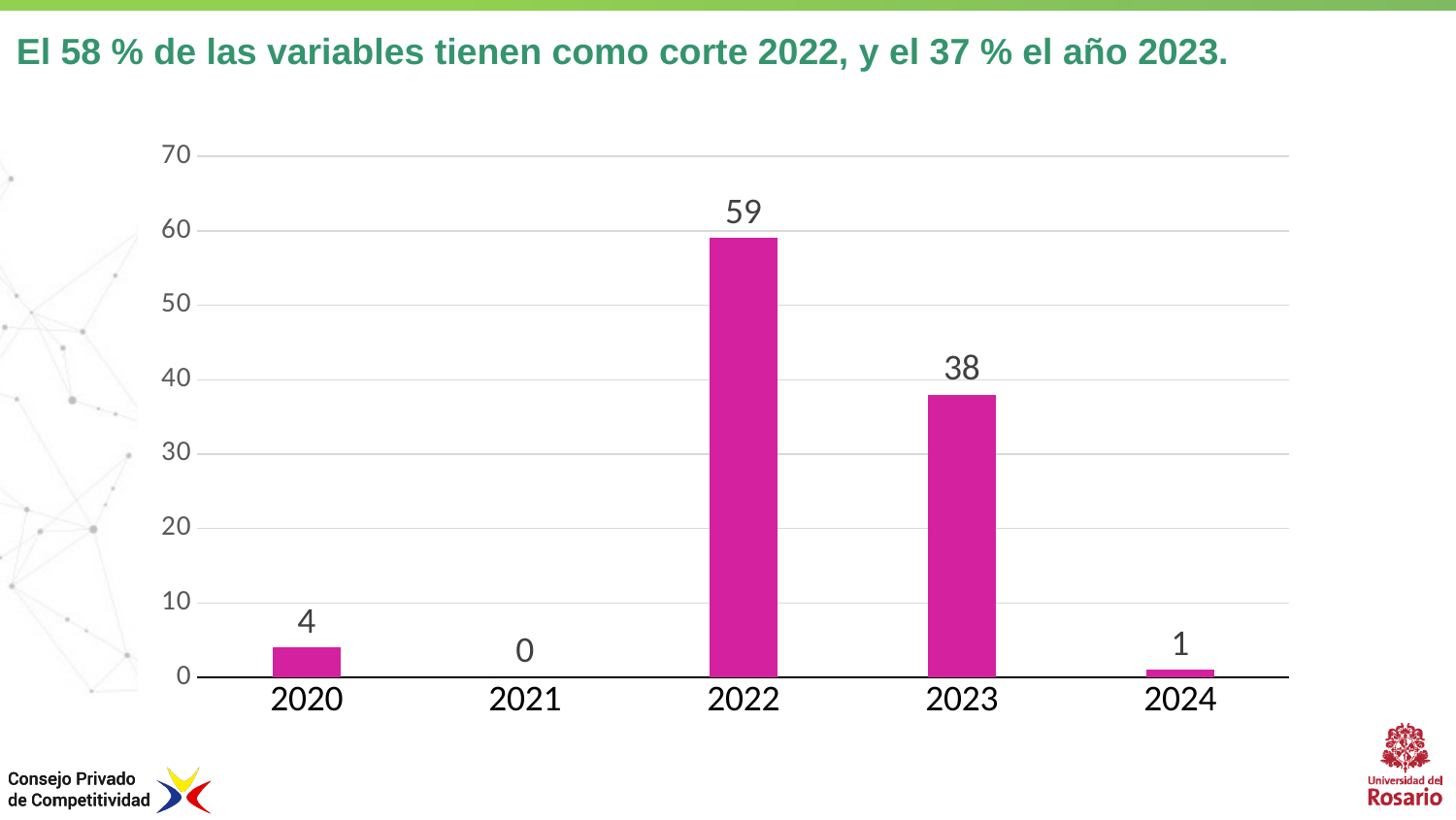
What is the value for 2022? 59 Which is larger, the value for 2020 or the value for 2024? 2020 How many years are shown on the x axis? 5 What kind of chart is shown on the slide? bar chart Which year has the highest value? 2022 What is the value for 2020? 4 What is the total of the values for 2020, 2021, 2022, 2023 and 2024? 102 What is the value for 2023? 38 Is the value for 2023 greater or less than 40? less Which year has the lowest value? 2021 What is the difference between the values for 2022 and 2023? 21 What is the value for 2021? 0